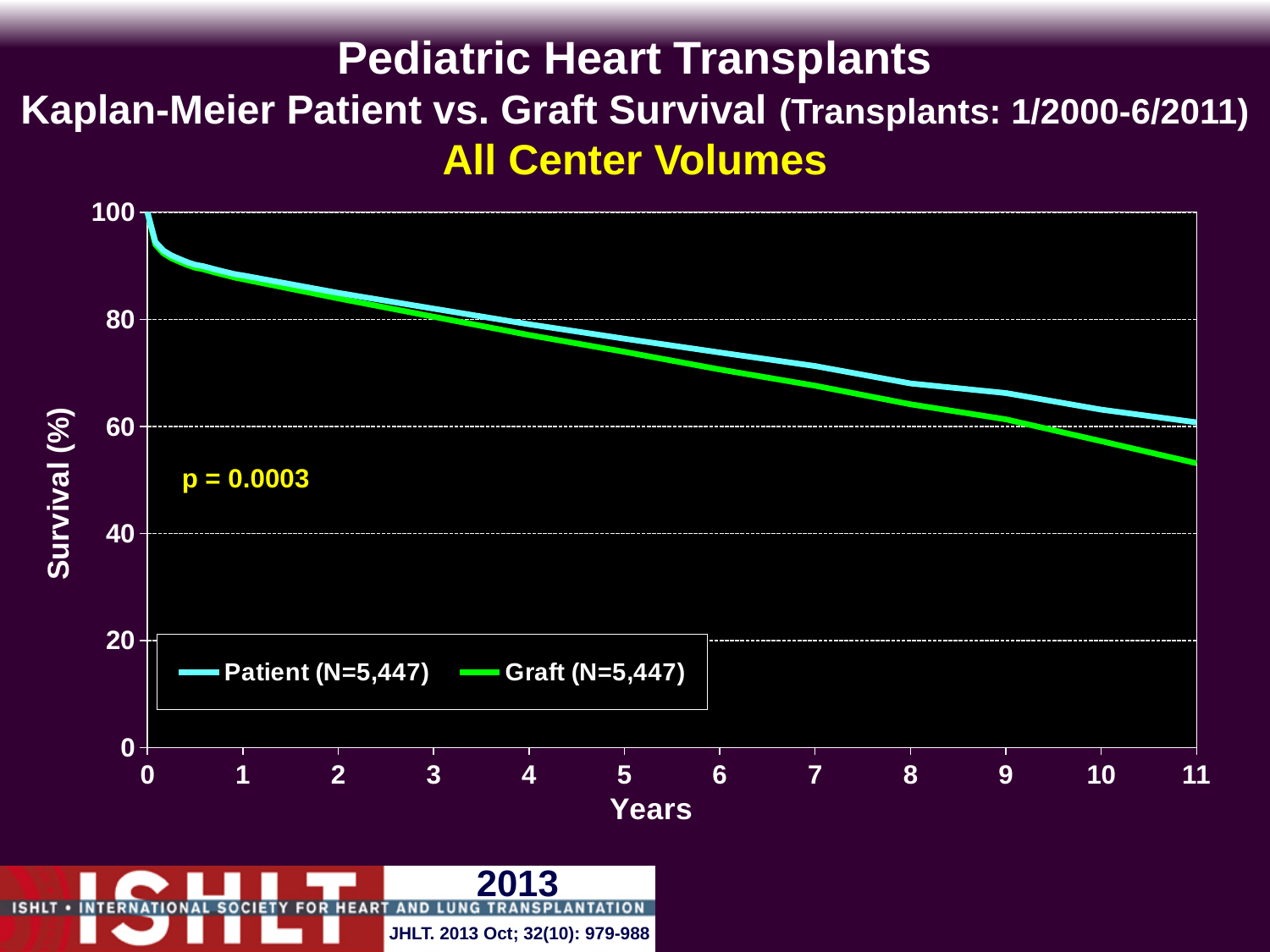
What is the p-value shown on the chart? p = 0.0003 What is the N for the Patient series in the legend? 5,447 Is the Graft survival value at year 1 greater or less than 80? greater Is the Graft survival value at year 5 greater or less than 60? greater At year 8, which curve is higher, Patient or Graft? Patient How many series does the legend list? 2 What kind of chart is shown on the slide? line chart Is the Patient survival value at year 5 greater or less than 80? less What is the label of the y axis? Survival (%) Do the survival curves rise or fall as the years increase? fall